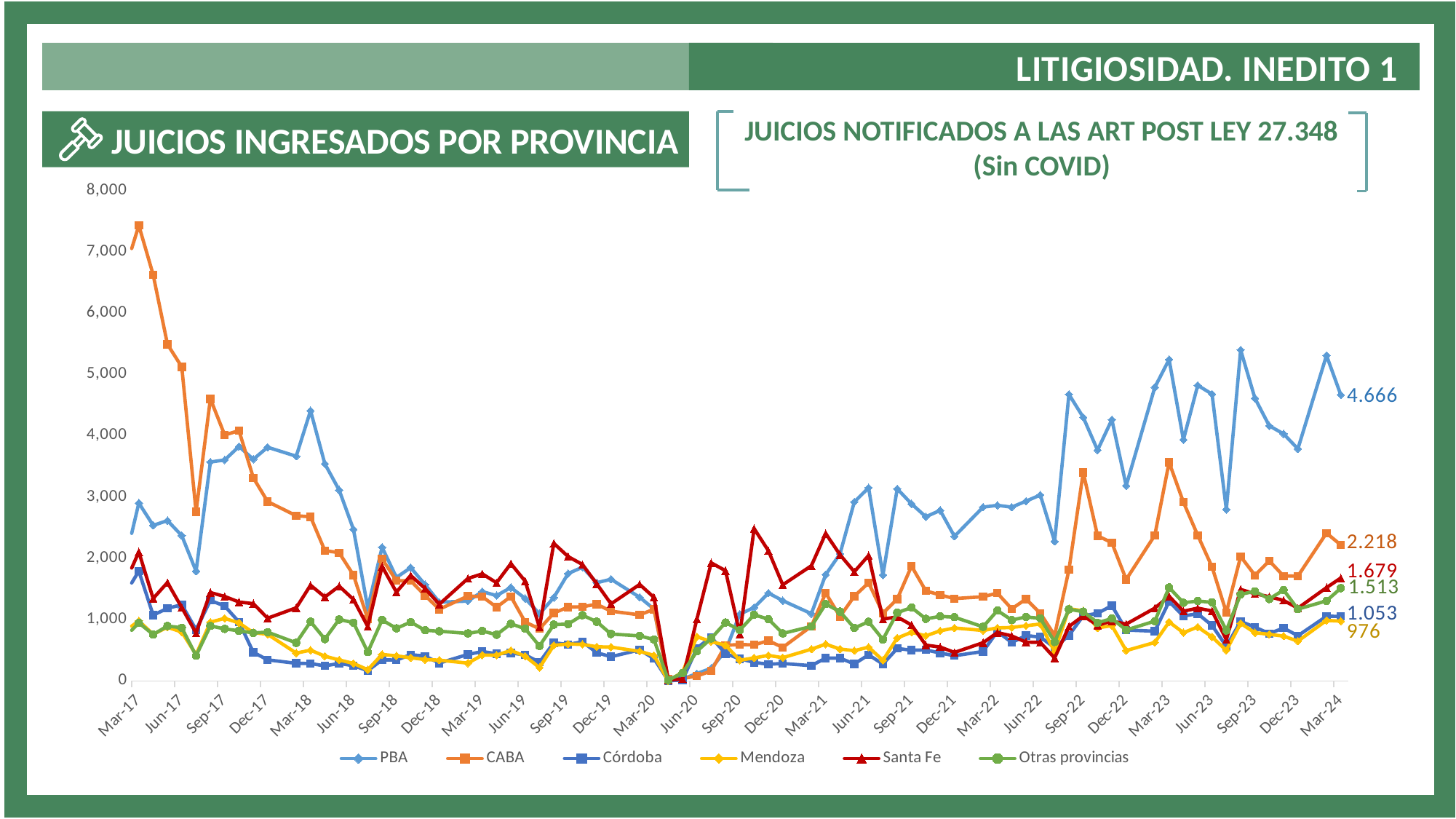
At Mar-24, which is larger: Córdoba or Otras provincias? Otras provincias Is the value for CABA at Mar-17 greater or less than 7,000? greater Does the CABA series rise or fall between Mar-17 and Mar-18? fall What is the value for CABA at Mar-24? 2.218 Which series has the lowest value at Mar-24? Mendoza What kind of chart is shown on the slide? line chart How many series does the legend list? 6 What is the value for Santa Fe at Mar-24? 1.679 What is the value for Mendoza at Mar-24? 976 Which series has the highest value at Mar-24? PBA What is the difference between the PBA and CABA values at Mar-24? 2.448 What is the value for PBA at Mar-24? 4.666